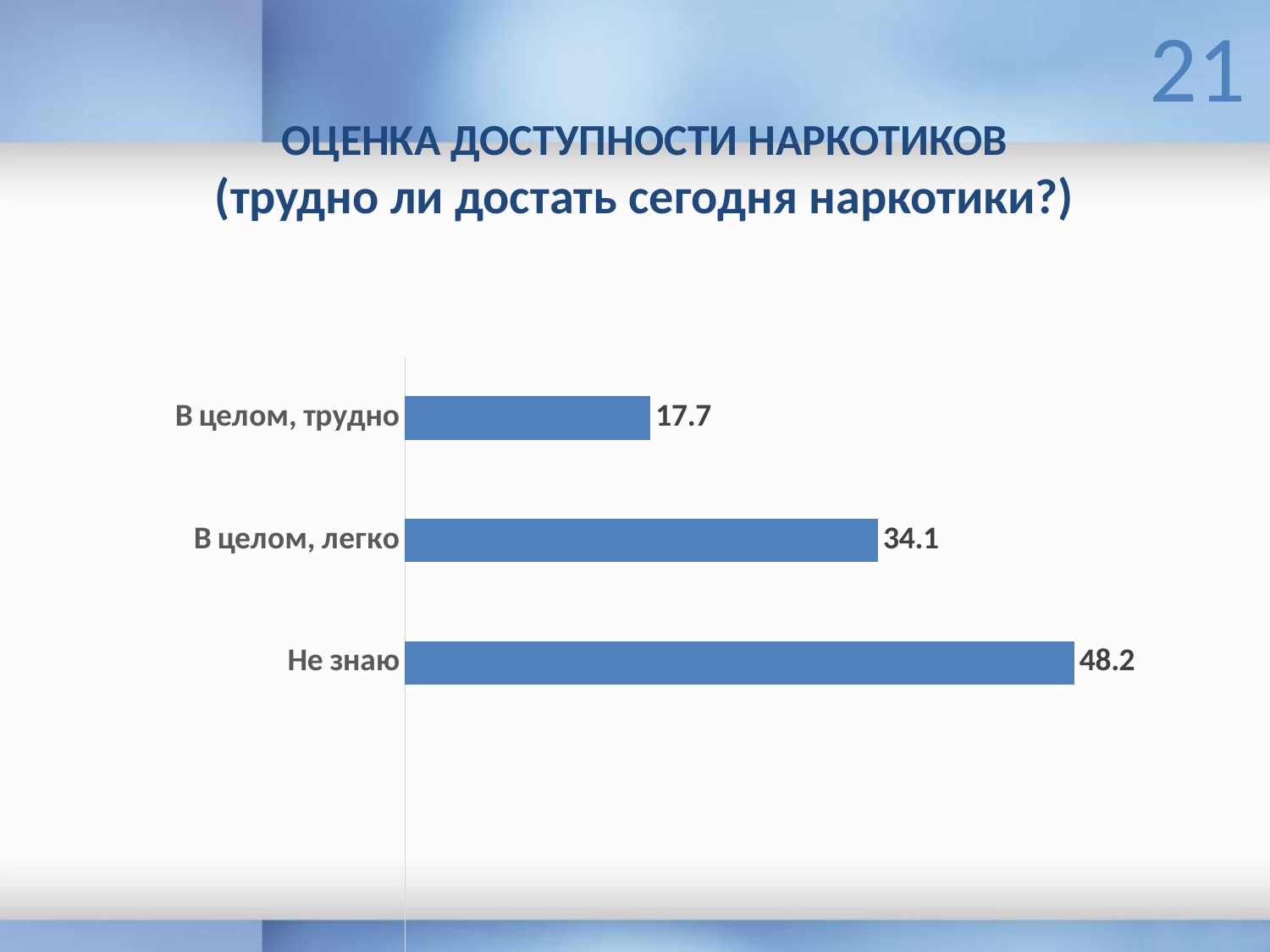
How many categories are shown in the chart? 3 What is the difference between the values for "Не знаю" and "В целом, легко"? 14.1 What is the value for "В целом, трудно"? 17.7 Which category has the highest value? Не знаю What kind of chart is shown on the slide? Bar chart What is the value for "В целом, легко"? 34.1 What is the value for "Не знаю"? 48.2 Which is larger: the value for "В целом, легко" or the value for "В целом, трудно"? В целом, легко What is the title of the slide? ОЦЕНКА ДОСТУПНОСТИ НАРКОТИКОВ (трудно ли достать сегодня наркотики?) What is the difference between the values for "В целом, легко" and "В целом, трудно"? 16.4 What is the total of the three values shown in the chart? 100 Which category has the lowest value? В целом, трудно